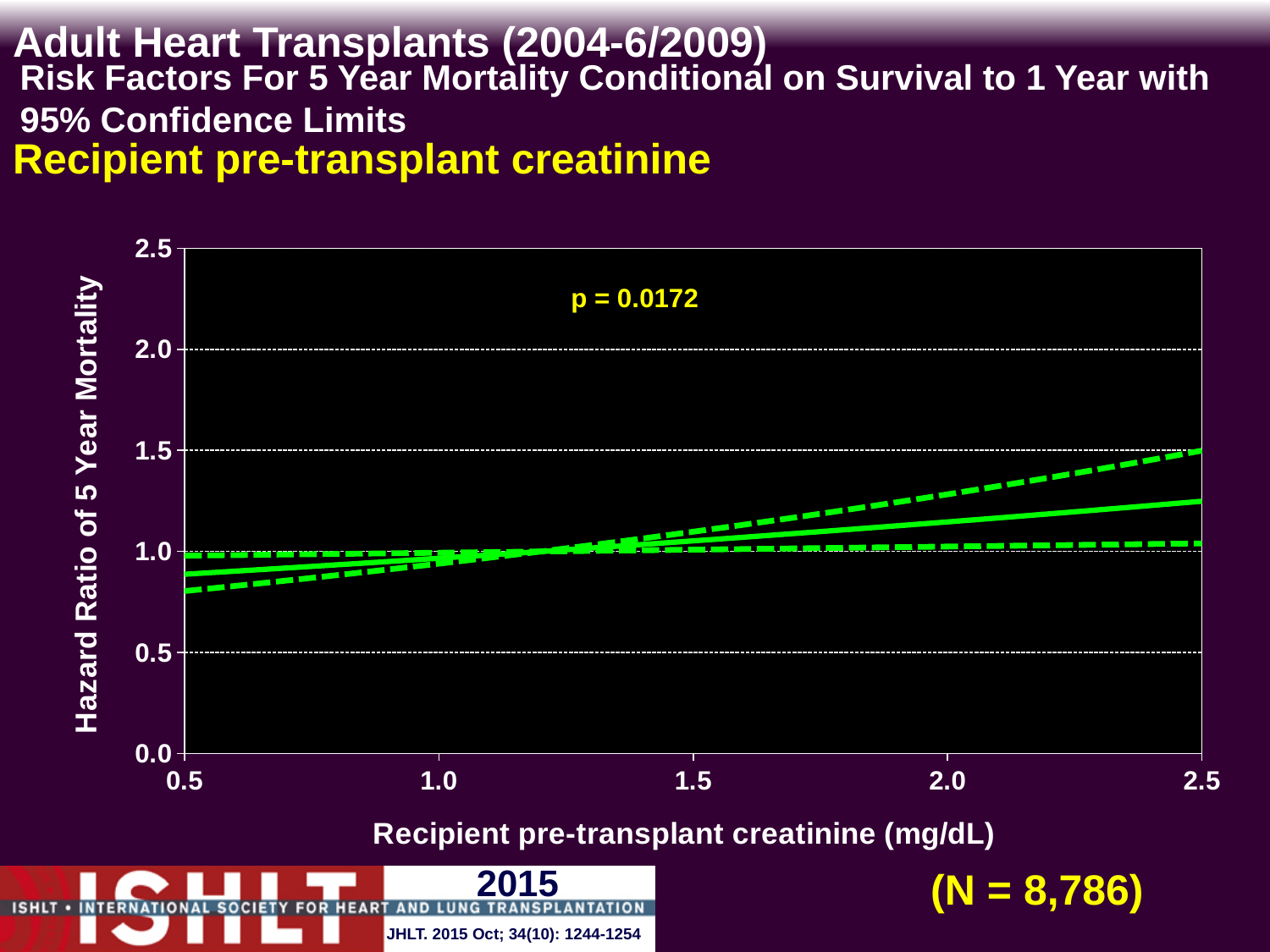
Is the hazard ratio on the solid line at a creatinine of 2.5 mg/dL greater or less than 1.0? greater Is the hazard ratio on the solid line higher at a creatinine of 2.5 mg/dL or at 0.5 mg/dL? 2.5 mg/dL Is the lower dashed confidence limit at a creatinine of 0.5 mg/dL greater or less than 1.0? less What kind of chart is shown on the slide? line chart How many lines are plotted on the chart? 3 Does the hazard ratio of 5 year mortality rise or fall as recipient pre-transplant creatinine increases? rise Is the hazard ratio on the solid line at a creatinine of 0.5 mg/dL greater or less than 1.0? less What p-value is printed on the chart? p = 0.0172 What is the sample size (N) shown on the slide? N = 8,786